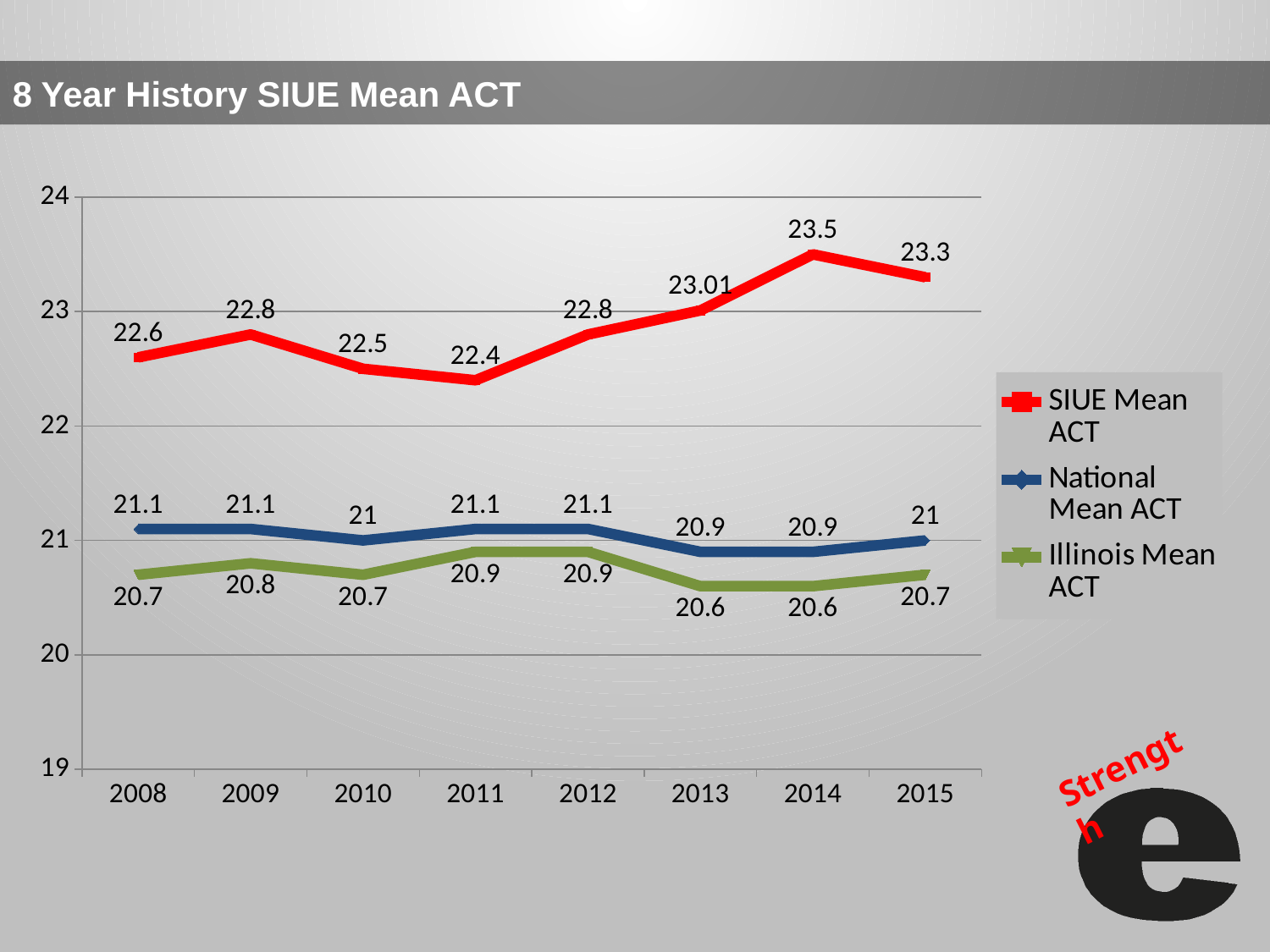
Which is larger in 2012: the National Mean ACT or the Illinois Mean ACT? National Mean ACT Does the SIUE Mean ACT rise or fall from 2011 to 2014? Rise How many years are shown on the x axis? 8 In which year is the SIUE Mean ACT lowest? 2011 In which year is the SIUE Mean ACT highest? 2014 What kind of chart is shown on the slide? Line chart How many series does the legend list? 3 What is the Illinois Mean ACT value for 2009? 20.8 What is the National Mean ACT value for 2013? 20.9 What is the SIUE Mean ACT value for 2014? 23.5 What is the difference between the SIUE Mean ACT and the Illinois Mean ACT in 2015? 2.6 Is the SIUE Mean ACT for 2013 greater or less than 23? greater